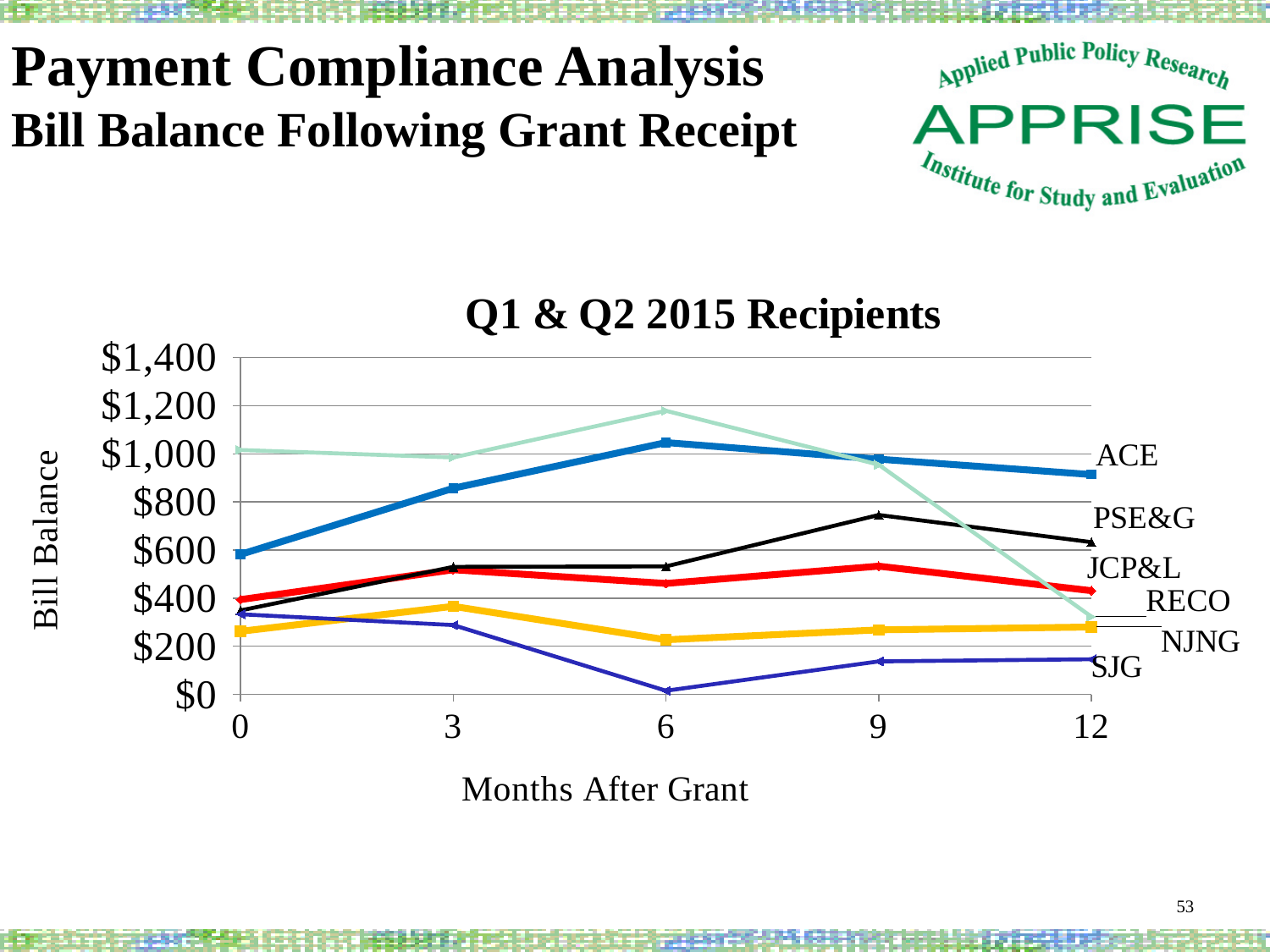
Is the bill balance for PSE&G at 9 months after grant greater or less than $600? greater Does the bill balance for ACE rise or fall from 0 to 6 months after grant? rise At 12 months after grant, which is larger, the bill balance for ACE or for PSE&G? ACE What is the title of the chart? Q1 & Q2 2015 Recipients How many series are plotted in the chart? 6 Which series has the lowest bill balance at 12 months after grant? SJG Is the bill balance for SJG at 6 months after grant greater or less than $200? less Is the bill balance for ACE at 3 months after grant greater or less than $800? greater Which series has the highest bill balance at 12 months after grant? ACE What kind of chart is shown on the slide? line chart What is the label of the x axis? Months After Grant How many points are marked on the x axis (Months After Grant)? 5